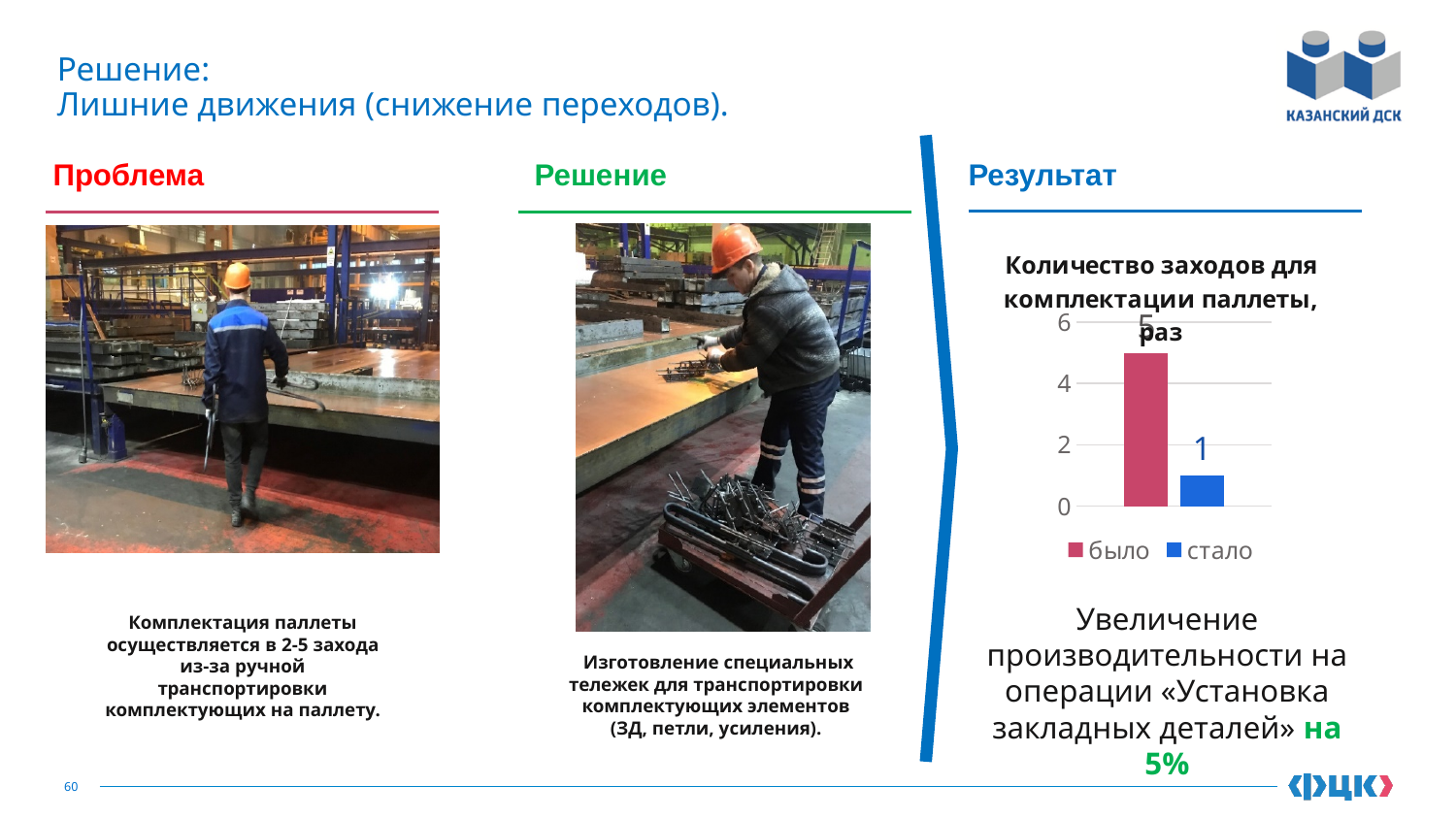
What is the difference between the «было» and «стало» values? 4 Which series has the higher value, «было» or «стало»? было What is the value for «было» in the chart? 5 Is the value for «стало» greater or less than 2? less Is the value for «было» greater or less than 4? greater What colour is the «стало» bar in the chart? blue What kind of chart is shown on the slide? bar chart What is the title of the chart? Количество заходов для комплектации паллеты, раз Which series has the lowest value in the chart? стало What is the value for «стало» in the chart? 1 What is the highest value shown on the chart's vertical axis? 6 How many series does the chart legend list? 2